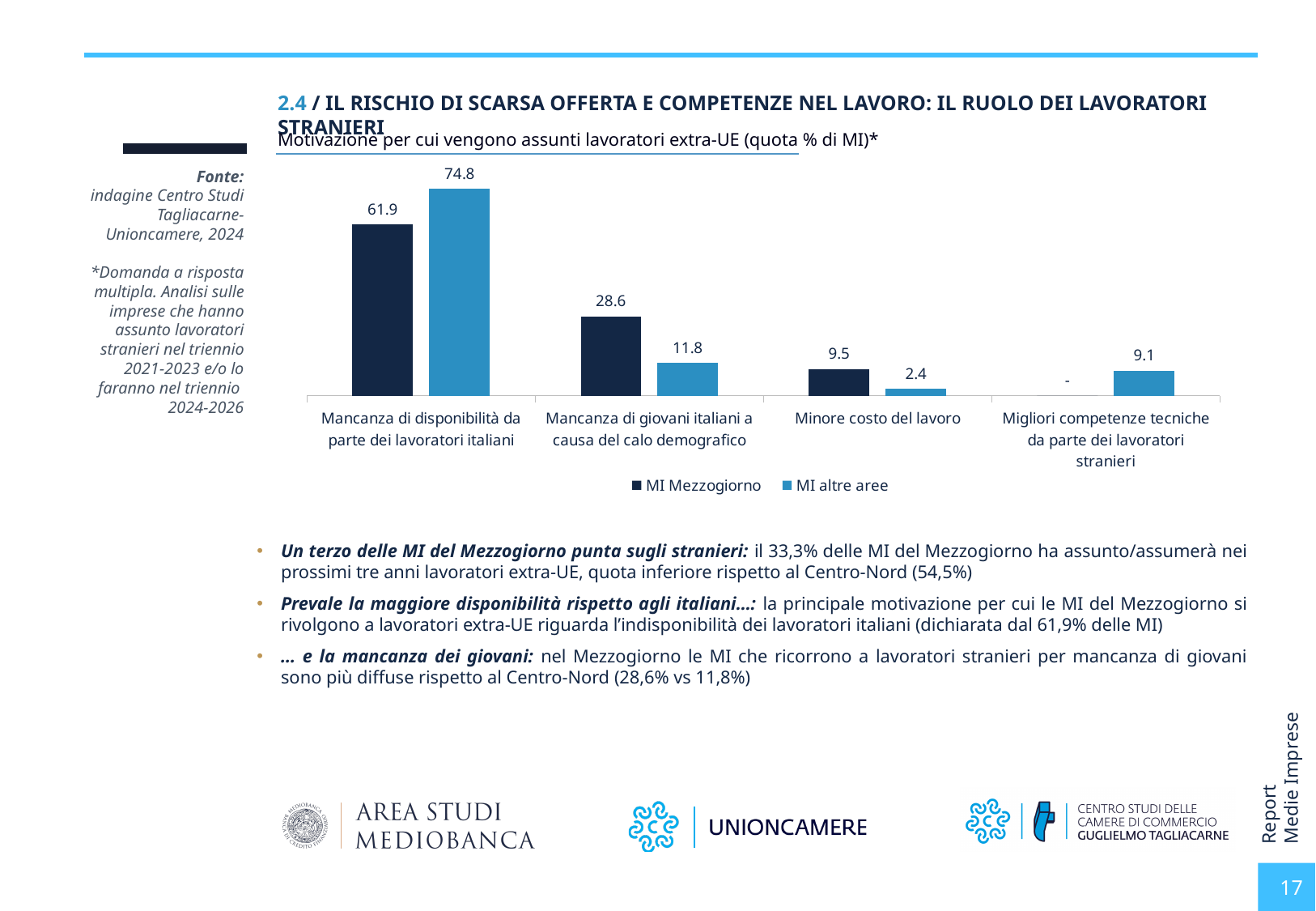
What is the value for MI altre aree in the category "Migliori competenze tecniche da parte dei lavoratori stranieri"? 9.1 What is the value for MI altre aree in the category "Minore costo del lavoro"? 2.4 Which category has the highest value for MI altre aree? Mancanza di disponibilità da parte dei lavoratori italiani How many categories are shown on the x axis of the chart? 4 Which category has the lowest value for MI altre aree? Minore costo del lavoro What is the difference between MI Mezzogiorno and MI altre aree in the category "Mancanza di giovani italiani a causa del calo demografico"? 16.8 What is the value for MI Mezzogiorno in the category "Mancanza di giovani italiani a causa del calo demografico"? 28.6 In the category "Minore costo del lavoro", which series has the larger value, MI Mezzogiorno or MI altre aree? MI Mezzogiorno What is the value for MI Mezzogiorno in the category "Mancanza di disponibilità da parte dei lavoratori italiani"? 61.9 What kind of chart is shown on the slide? Bar chart What is the value for MI altre aree in the category "Mancanza di disponibilità da parte dei lavoratori italiani"? 74.8 How many series does the legend list? 2